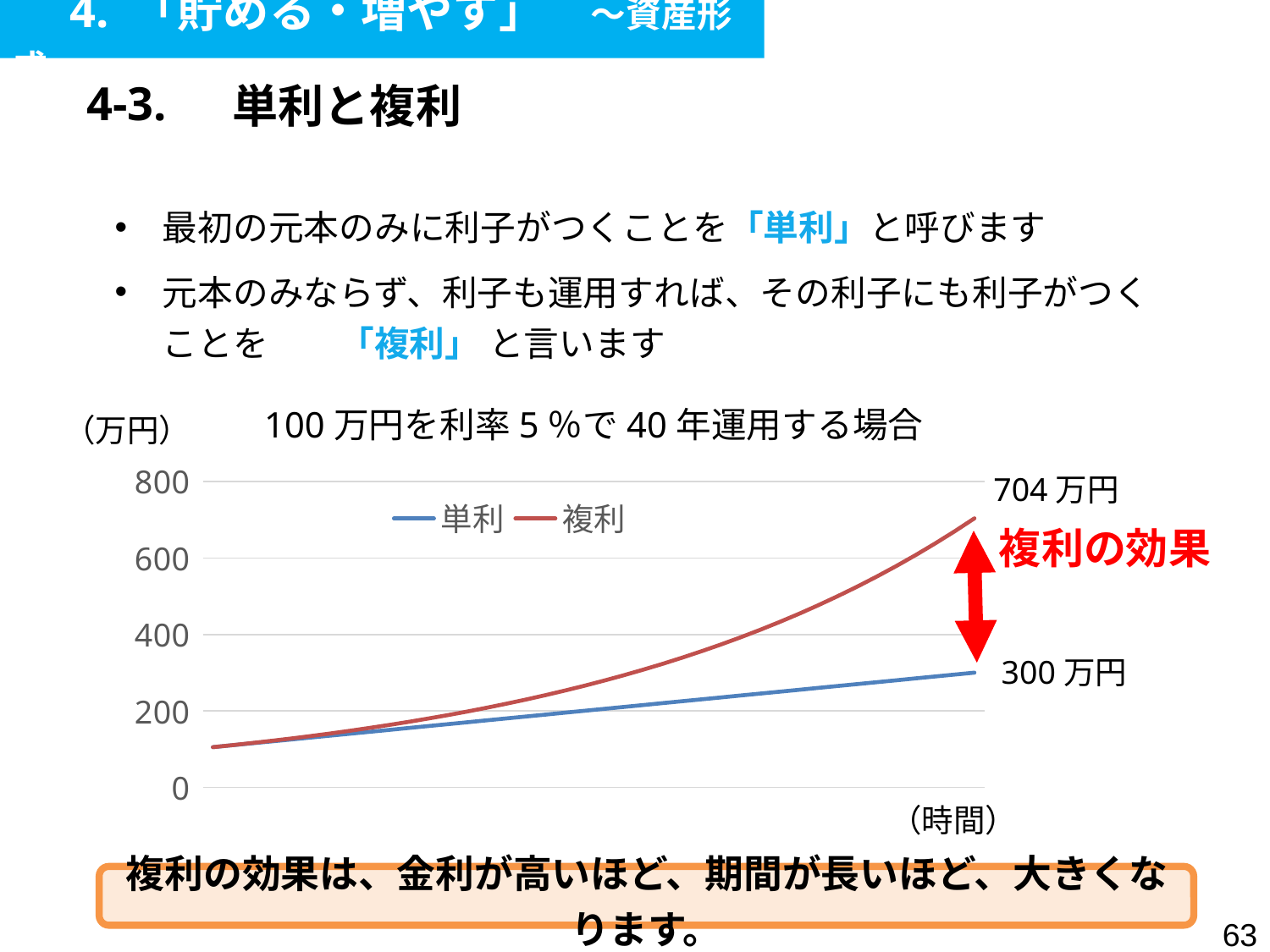
Which line ends at a higher value, 単利 or 複利? 複利 What is the difference between the final values of the 複利 and 単利 lines? 404万円 What kind of chart is shown on the slide? line chart What is the final value labelled for the 複利 (compound interest) line? 704万円 Is the final value of the 複利 line greater or less than 600? greater Is the final value of the 単利 line greater or less than 400? less What is the highest value shown on the chart's vertical axis? 800 How many series does the chart legend list? 2 What is the title shown above the chart? 100万円を利率5％で40年運用する場合 What are the two series named in the chart legend? 単利 and 複利 What is the final value labelled for the 単利 (simple interest) line? 300万円 Do the values of the 複利 line rise or fall along the x axis? rise